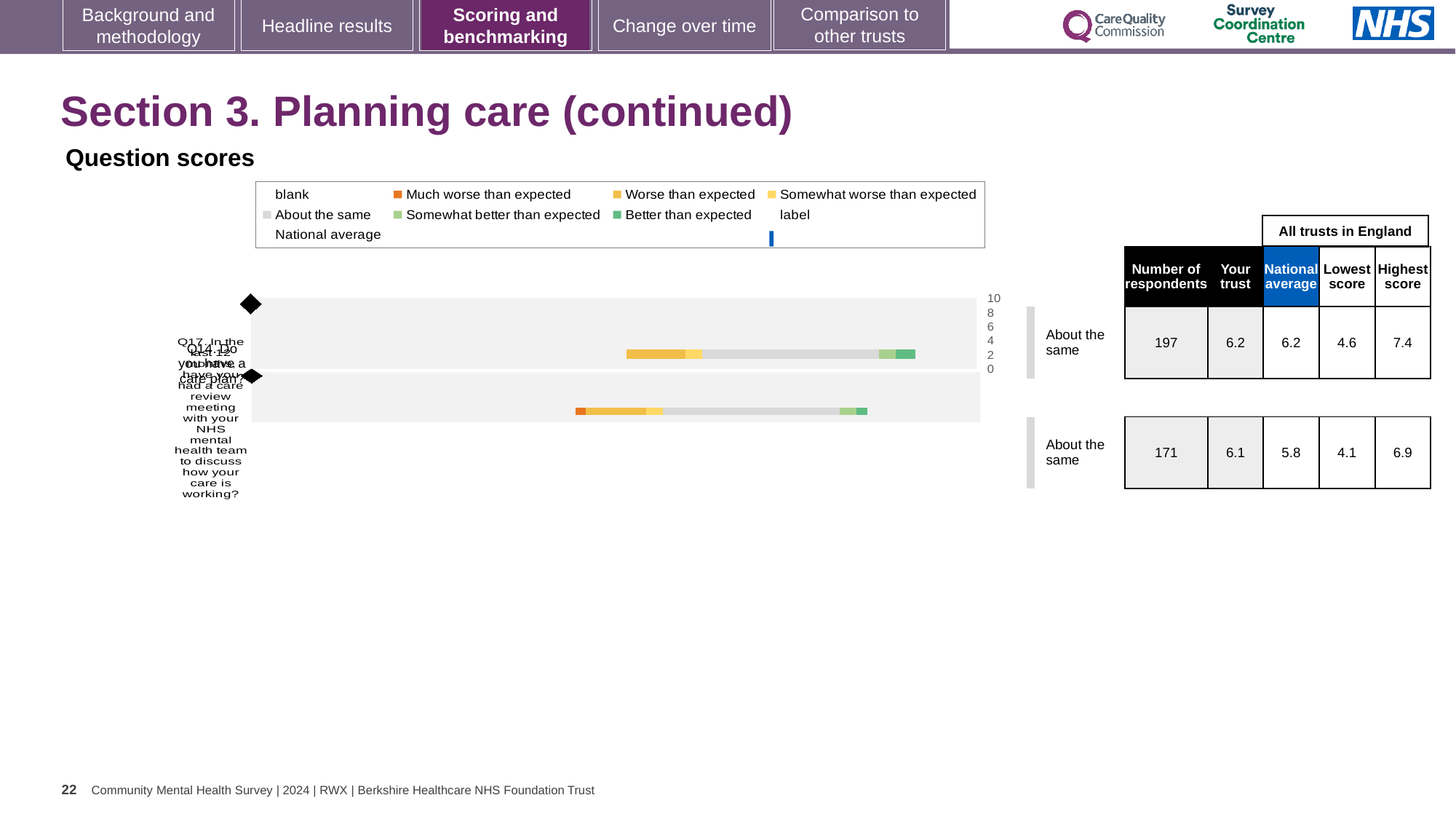
Which is larger for Q17: the 'Your trust' score or the national average? Your trust What is the national average score for Q17 (care review meeting in the last 12 months)? 5.8 What is the difference between the highest and lowest scores for Q14? 2.8 What kind of chart is used to show the question scores on this slide? bar chart What benchmark category is shown for both Q14 and Q17? About the same What is the difference between the 'Your trust' score and the national average for Q17? 0.3 What is the 'Your trust' score for Q14 (Do you have a care plan?)? 6.2 What is the number of respondents for Q14 (Do you have a care plan?)? 197 How many questions (bars) are plotted in the question scores chart? 2 What is the highest score among all trusts in England for Q17? 6.9 What is the lowest score among all trusts in England for Q14? 4.6 What is the maximum value shown on the score axis of the chart? 10